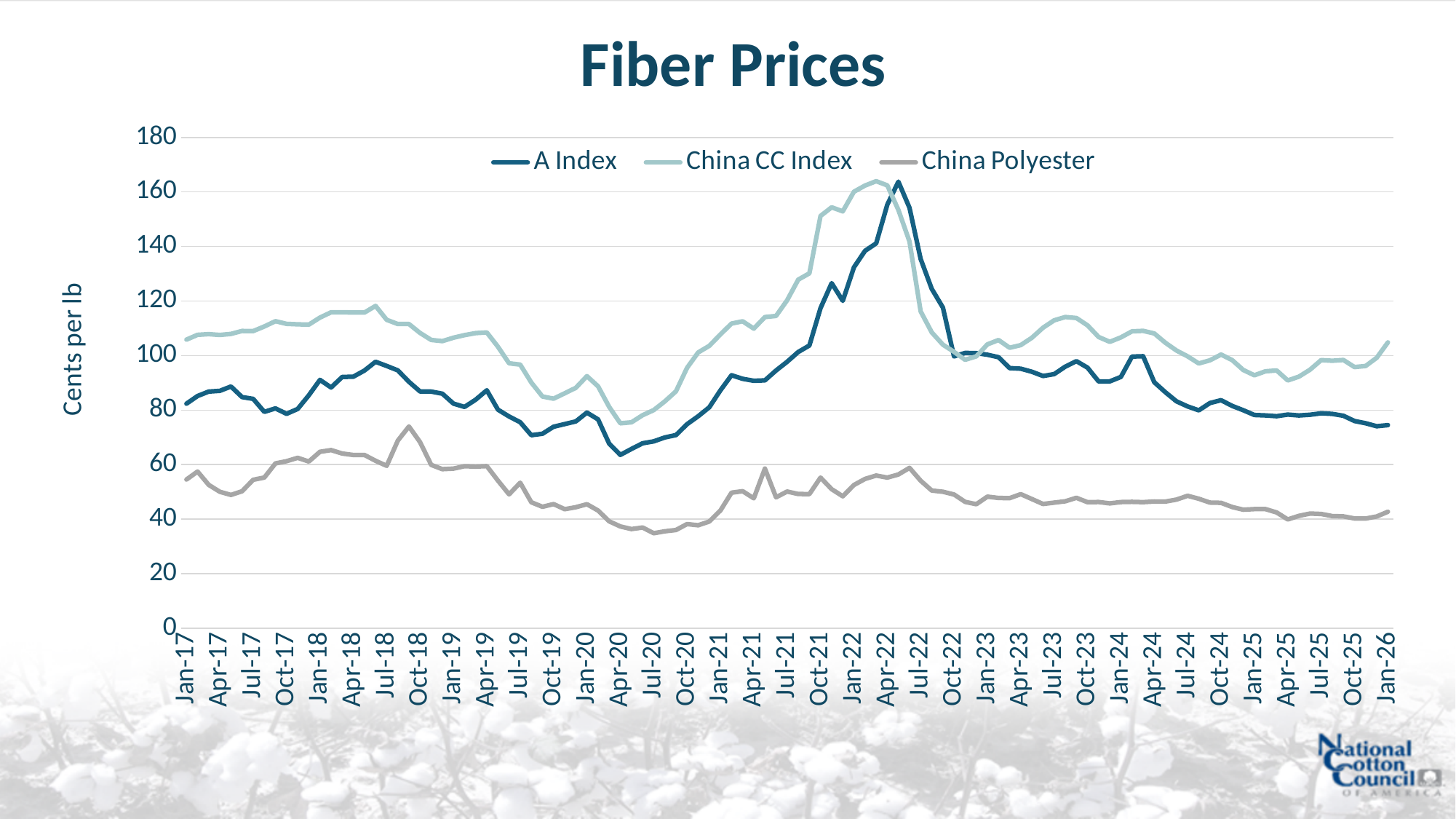
Is the value of the China CC Index at Apr-22 greater or less than 140? greater At Apr-22, which is higher, the A Index or China Polyester? A Index At Jan-26, which is higher, the A Index or the China CC Index? China CC Index What is the label on the vertical axis? Cents per lb What is the title of the chart? Fiber Prices Does the A Index rise or fall overall from Apr-20 to Apr-22? rise Which series has the lowest values across the whole period shown? China Polyester How many series does the legend list? 3 Is the value of China Polyester at Oct-18 greater or less than 60? greater What kind of chart is shown on the slide? line chart Is the value of China Polyester at Jul-20 greater or less than 40? less